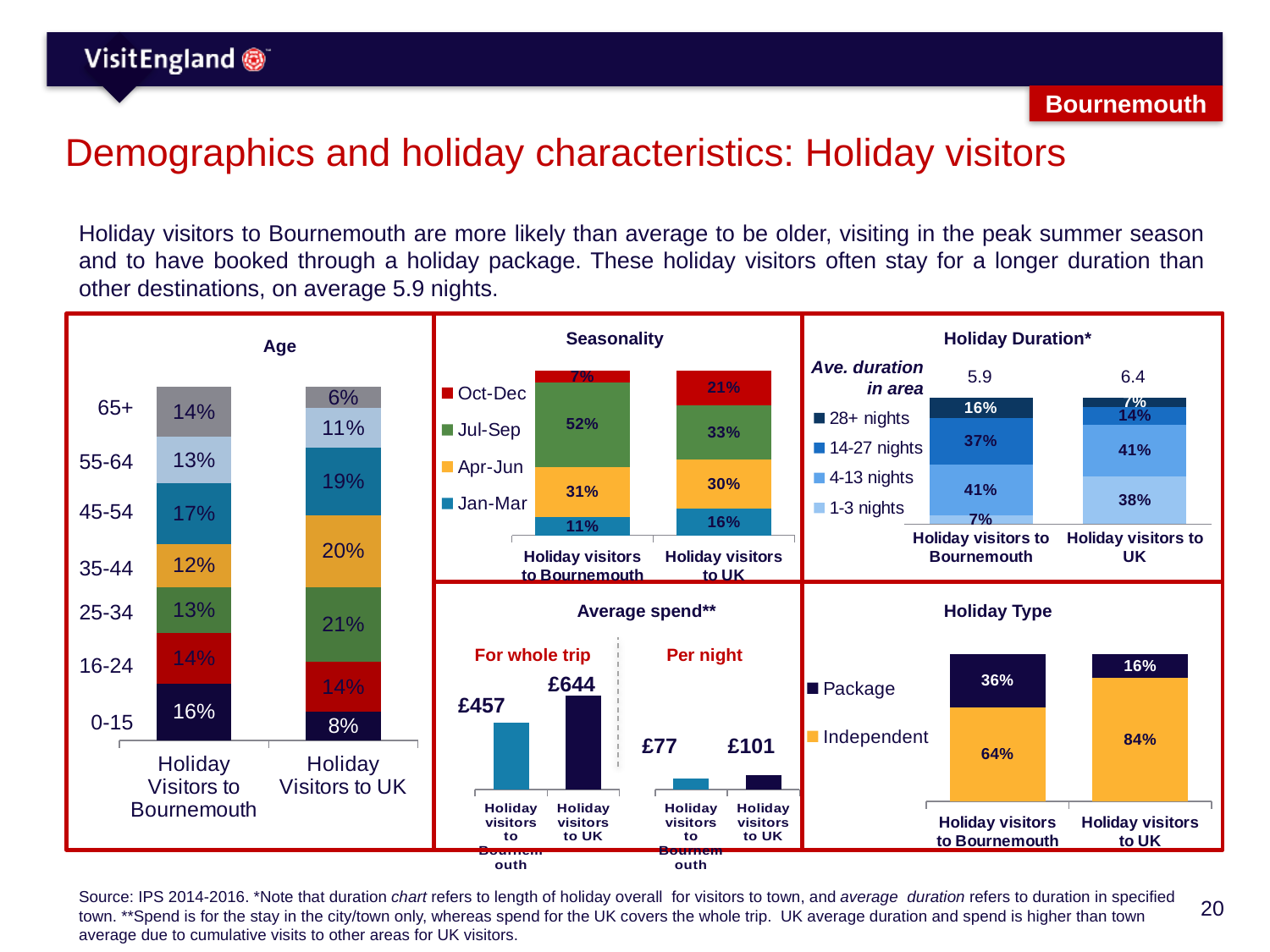
In the Holiday Type chart, what percentage of holiday visitors to Bournemouth booked a package? 36% What kind of chart is the Holiday Type chart? Stacked bar chart In the Seasonality chart, what percentage of holiday visitors to Bournemouth visit in Jul-Sep? 52% In the Average spend chart, what is the difference in per night spend between holiday visitors to UK and holiday visitors to Bournemouth? £24 In the Holiday Duration chart, which is larger: the 1-3 nights share for holiday visitors to Bournemouth or for holiday visitors to UK? Holiday visitors to UK In the Holiday Duration chart, what is the average duration in area for holiday visitors to Bournemouth? 5.9 In the Age chart, what share of holiday visitors to Bournemouth are aged 65+? 14% In the Seasonality chart, how many series does the legend list? 4 In the Average spend chart, what is the average spend for the whole trip for holiday visitors to Bournemouth? £457 In the Age chart, what is the difference between the 0-15 share for holiday visitors to Bournemouth and for holiday visitors to UK? 8% In the Seasonality chart, which quarter has the smallest share of holiday visitors to Bournemouth? Oct-Dec In the Age chart, which age group is the largest among holiday visitors to the UK? 25-34